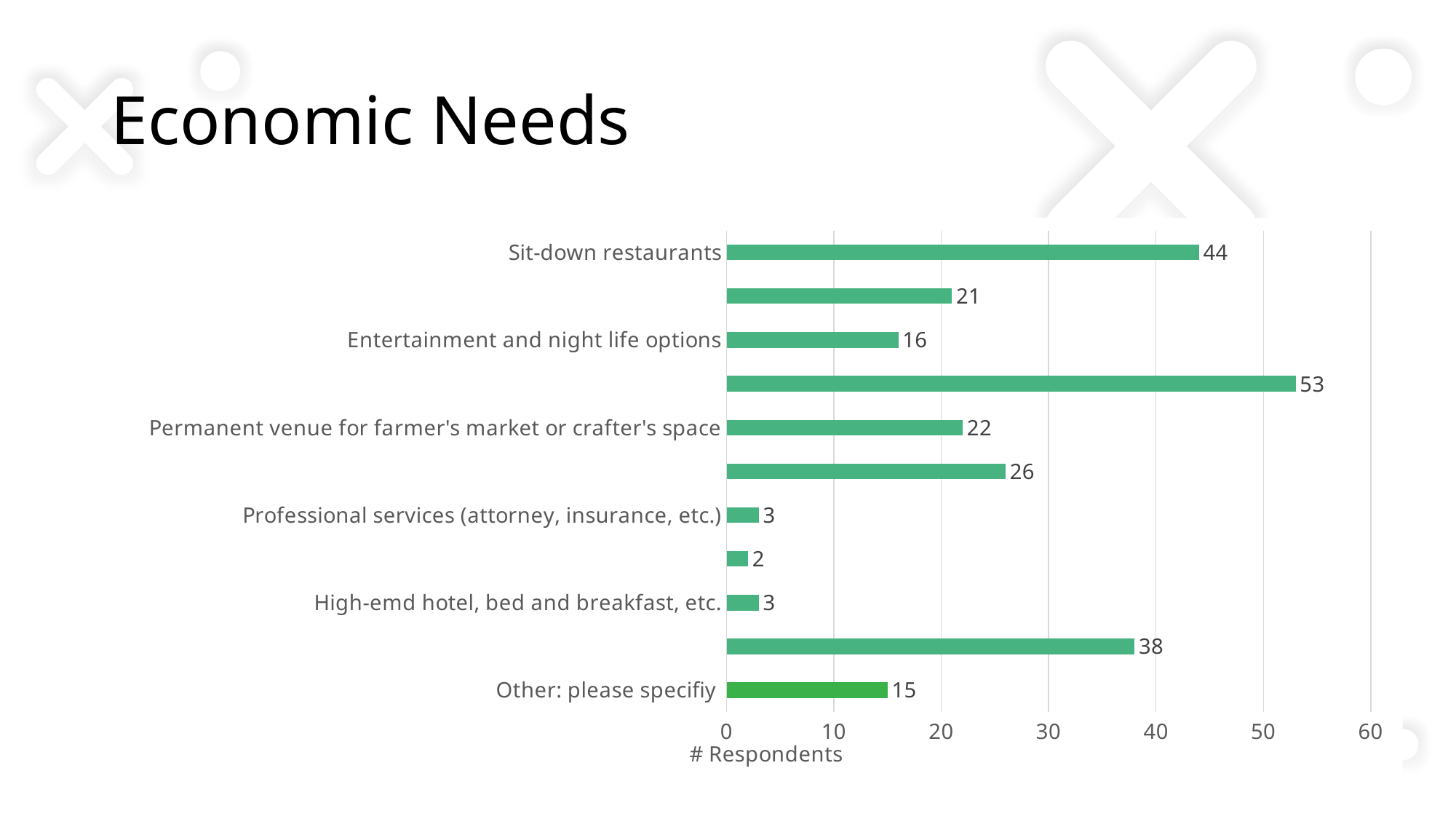
How many bars are plotted in the chart? 11 What is the value for Entertainment and night life options? 16 What is the value for Other: please specifiy? 15 What is the difference between the values for Sit-down restaurants and Entertainment and night life options? 28 What kind of chart is shown on the slide? bar chart What is the value for Professional services (attorney, insurance, etc.)? 3 What is the value for Permanent venue for farmer's market or crafter's space? 22 What is the title of the horizontal axis? # Respondents Which has a larger value, Sit-down restaurants or Other: please specifiy? Sit-down restaurants What is the largest value labeled on any bar in the chart? 53 What is the smallest value labeled on any bar in the chart? 2 How many respondents selected Sit-down restaurants? 44